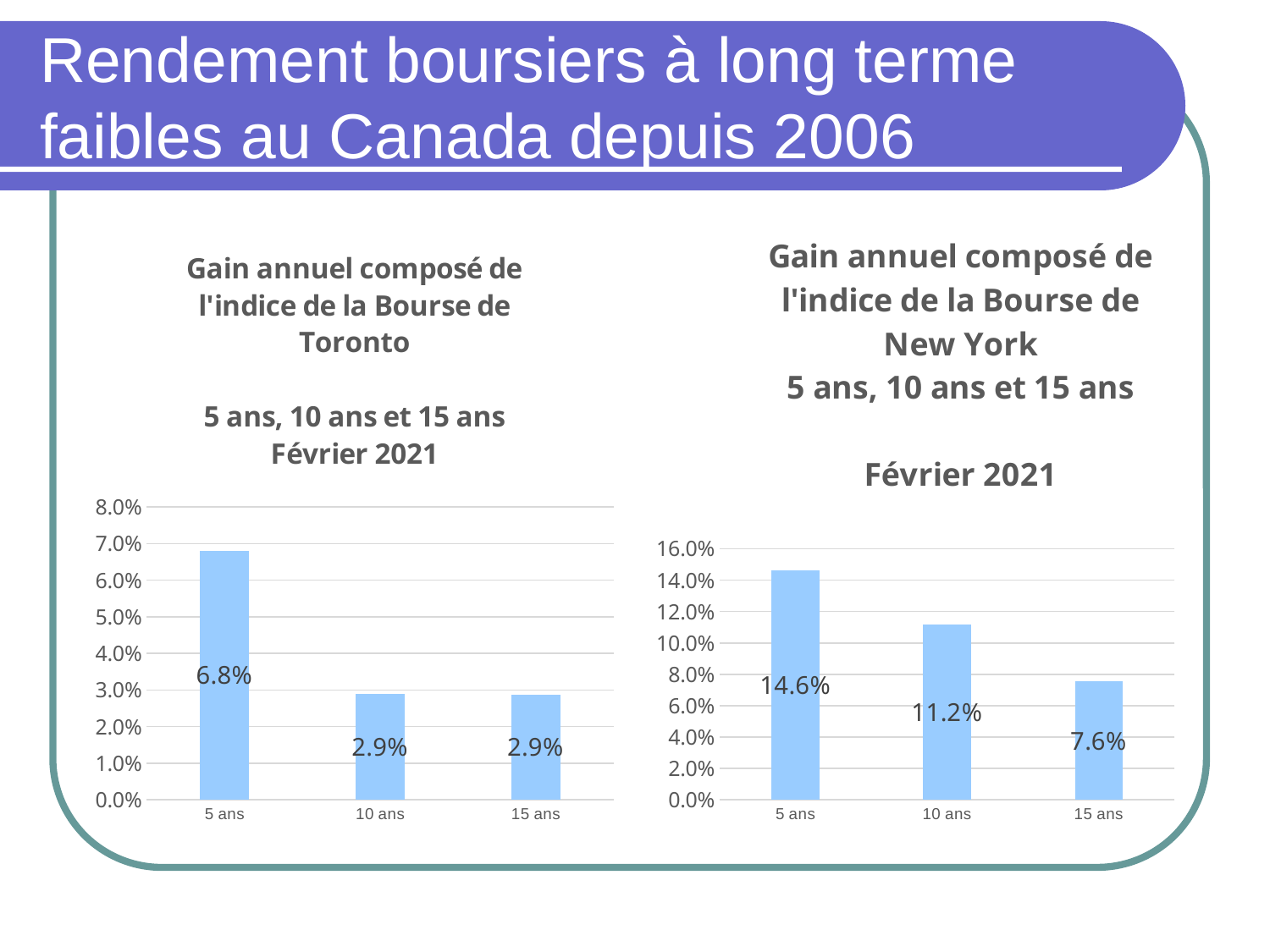
What kind of chart is the Toronto chart (left)? Bar chart In the New York chart (right), which category has the lowest value? 15 ans In the New York chart (right), what is the difference between the 5 ans and 10 ans values? 3.4% In the New York chart (right), what is the value for 5 ans? 14.6% In the Toronto chart (left), what is the difference between the 5 ans and 15 ans values? 3.9% Which is larger: the 10 ans value in the Toronto chart or the 10 ans value in the New York chart? New York chart How many categories are shown in the New York chart (right)? 3 In the Toronto chart (left), what is the value for 5 ans? 6.8% In the Toronto chart (left), which category has the highest value? 5 ans In the New York chart (right), what is the value for 15 ans? 7.6% In the Toronto chart (left), what is the value for 10 ans? 2.9% In the New York chart (right), which category has the highest value? 5 ans